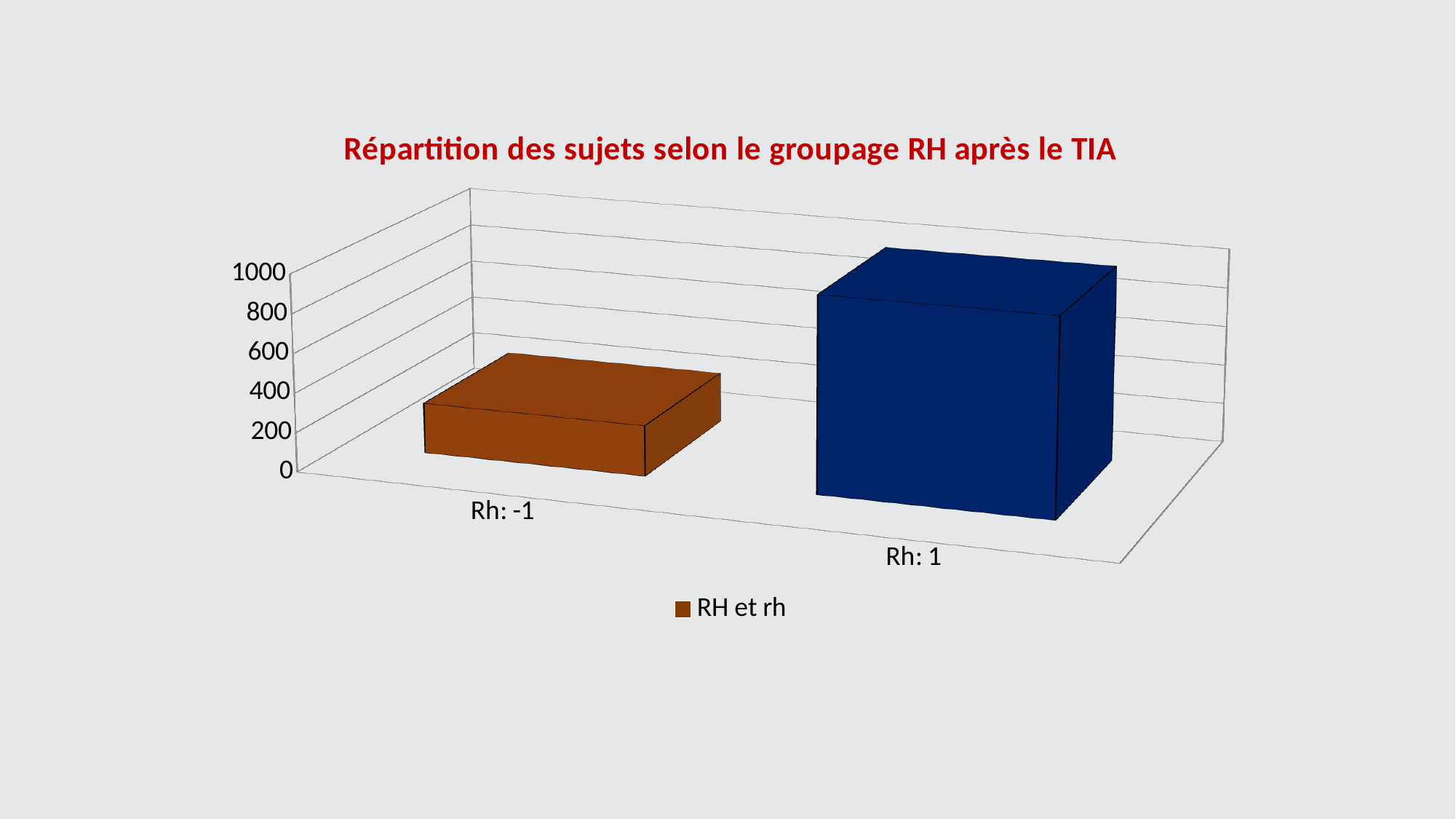
Which category has the highest value? Rh: 1 Which category has the lowest value? Rh: -1 What kind of chart is shown on the slide? bar chart Is the value for Rh: -1 greater or less than 600? less Is the value for Rh: 1 greater or less than 400? greater What series name is shown in the legend? RH et rh Which is larger, the value for Rh: -1 or the value for Rh: 1? Rh: 1 What is the title of the chart? Répartition des sujets selon le groupage RH après le TIA How many series does the legend list? 1 Is the value for Rh: 1 greater or less than 600? greater How many categories are shown on the x axis of the chart? 2